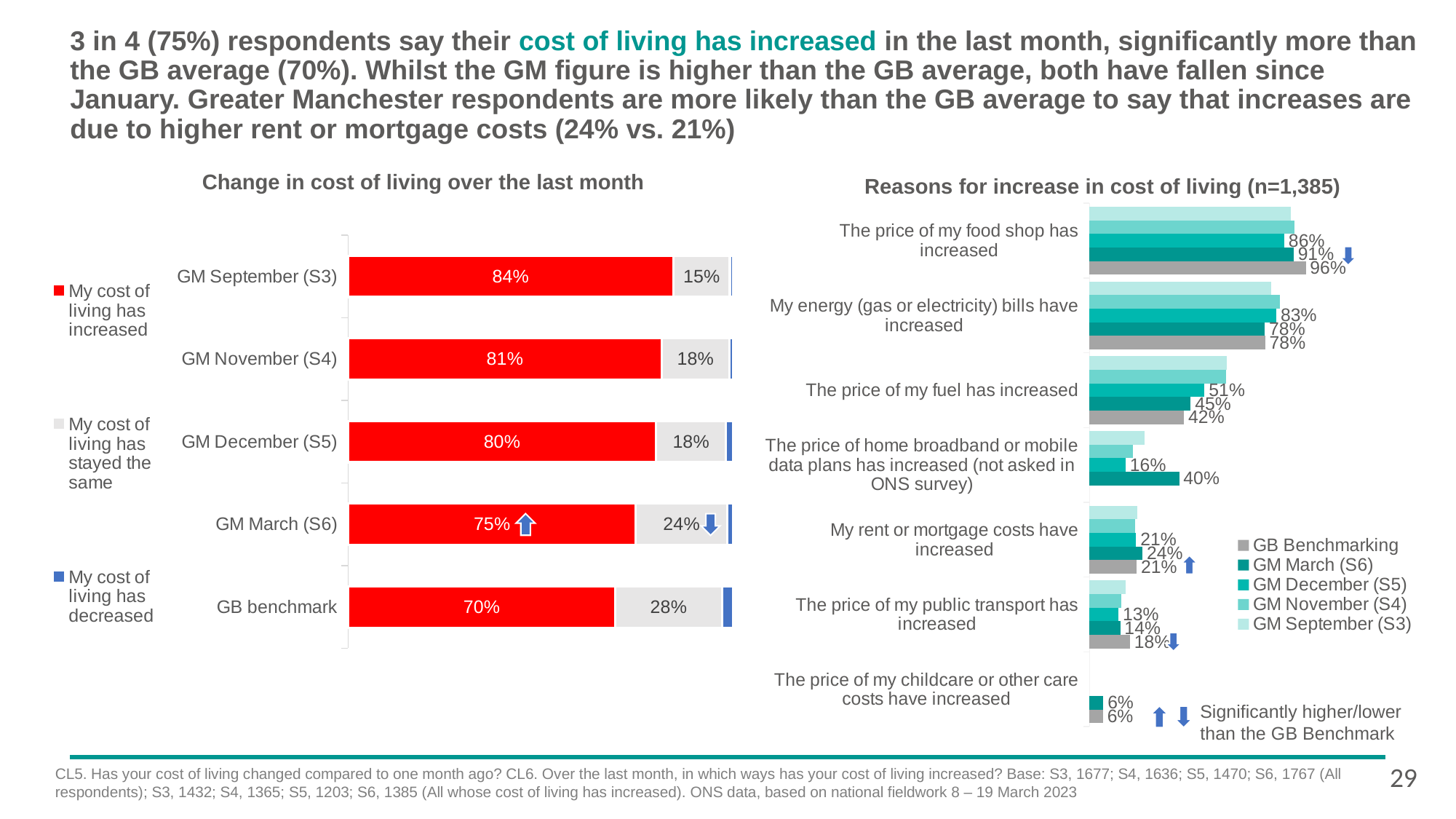
In the 'Change in cost of living over the last month' chart, what percentage of GM March (S6) respondents say their cost of living has increased? 75% How many categories are shown in the 'Change in cost of living over the last month' chart? 5 In the 'Change in cost of living over the last month' chart, what percentage of the GB benchmark say their cost of living has stayed the same? 28% In the 'Reasons for increase in cost of living' chart, what is the GM March (S6) value for 'The price of home broadband or mobile data plans has increased'? 40% How many reasons are listed in the 'Reasons for increase in cost of living' chart? 7 In the 'Change in cost of living over the last month' chart, which category has the highest share saying their cost of living has increased? GM September (S3) What kind of chart is 'Change in cost of living over the last month'? Bar chart In the 'Reasons for increase in cost of living' chart, what is the GB Benchmarking value for 'The price of my food shop has increased'? 96% In the 'Change in cost of living over the last month' chart, does the share saying their cost of living has increased rise or fall from GM September (S3) to GM March (S6)? Fall How many series does the legend of the 'Change in cost of living over the last month' chart list? 3 In the 'Change in cost of living over the last month' chart, what is the difference between the 'increased' share for GM September (S3) and the GB benchmark? 14 percentage points How many series does the legend of the 'Reasons for increase in cost of living' chart list? 5